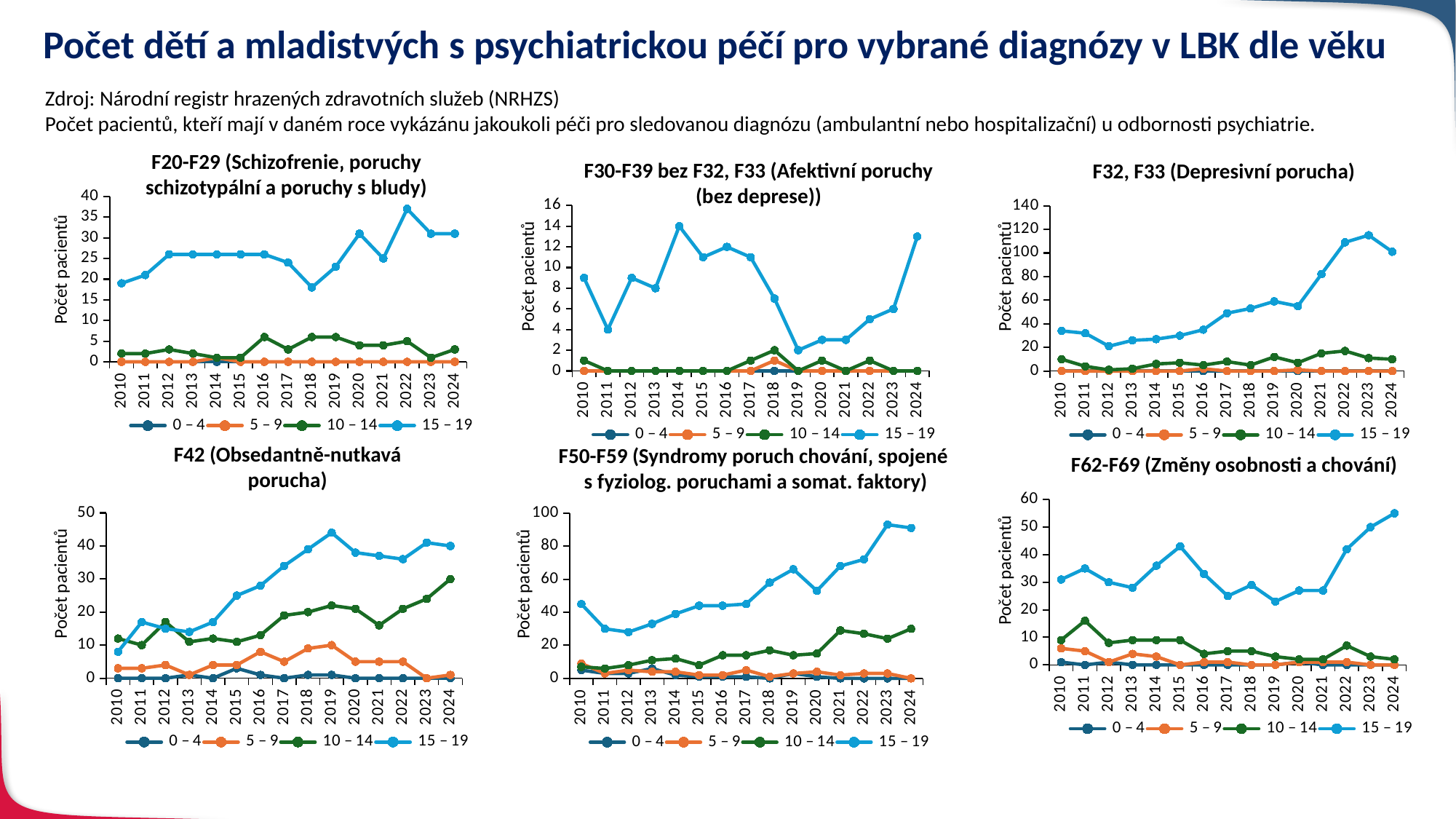
How many years are plotted on the x axis of the F20-F29 chart? 15 In the F32, F33 (Depresivní porucha) chart, is the value for the 15 – 19 series in 2023 greater or less than 100? greater How many series does the legend of the F32, F33 (Depresivní porucha) chart list? 4 In the F50-F59 chart, is the value for the 10 – 14 series in 2021 greater or less than 20? greater In the F62-F69 (Změny osobnosti a chování) chart, which year has the highest value for the 15 – 19 series? 2024 What is the y-axis label of the F50-F59 chart? Počet pacientů What kind of chart is the F42 (Obsedantně-nutkavá porucha) chart? line chart In the F32, F33 (Depresivní porucha) chart, does the 15 – 19 series rise or fall from 2019 to 2023? rise In the F62-F69 chart, which year has the larger value for the 15 – 19 series: 2015 or 2019? 2015 In the F42 (Obsedantně-nutkavá porucha) chart, which series has the larger value in 2024: 10 – 14 or 15 – 19? 15 – 19 In the F62-F69 (Změny osobnosti a chování) chart, is the value for the 15 – 19 series in 2024 greater or less than 50? greater In the F30-F39 bez F32, F33 chart, which year has the lowest value for the 15 – 19 series? 2019